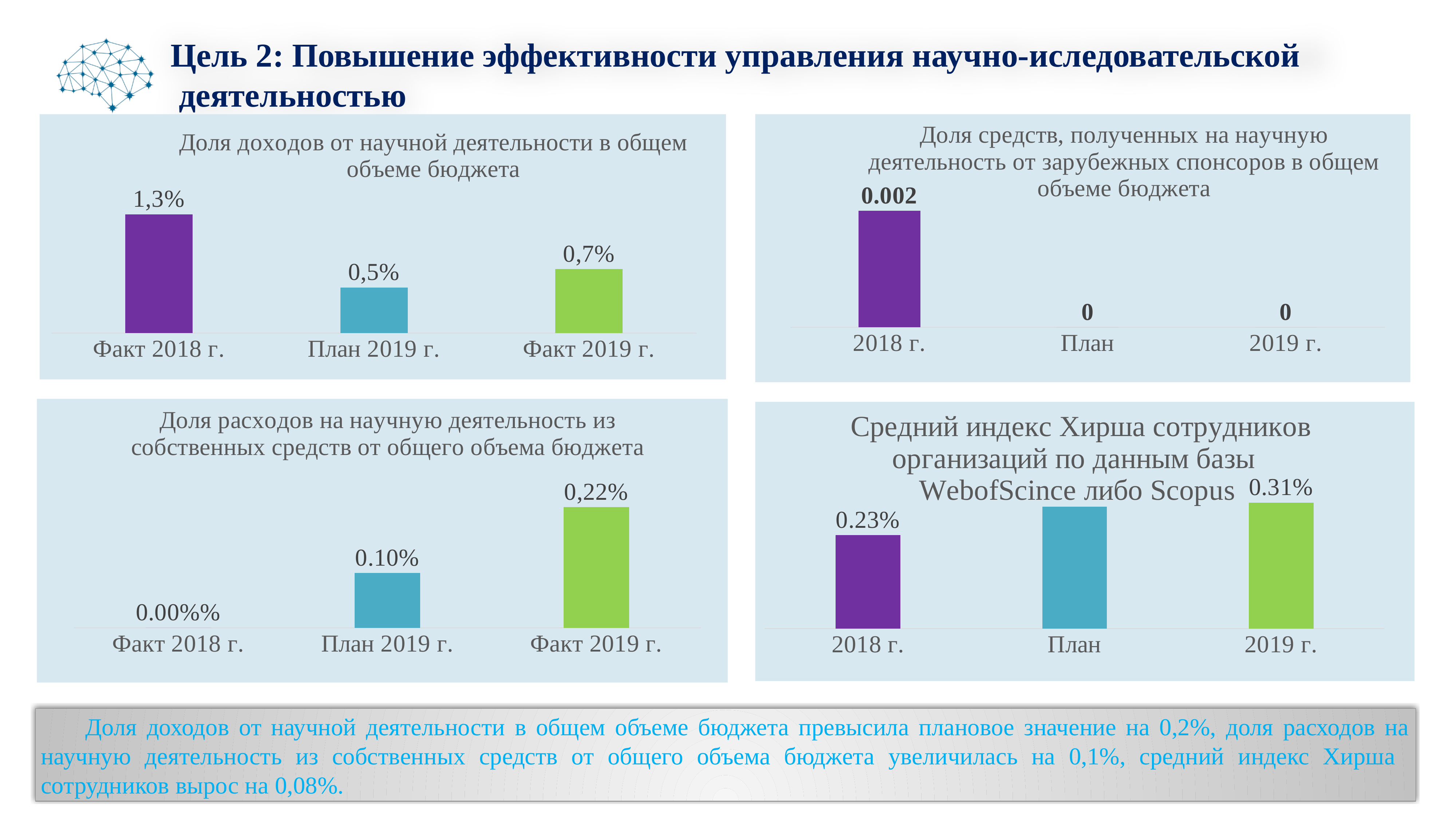
In the chart 'Доля расходов на научную деятельность из собственных средств от общего объема бюджета', what is the value for План 2019 г.? 0.10% In the top-right chart about funds from foreign sponsors, what is the value for План? 0 In the chart 'Доля расходов на научную деятельность из собственных средств от общего объема бюджета', do the values rise or fall from left to right? rise In the chart 'Доля доходов от научной деятельности в общем объеме бюджета', which category has the highest value? Факт 2018 г. In the bottom-right chart about the average Hirsch index, which is larger: 2018 г. or 2019 г.? 2019 г. In the chart 'Доля доходов от научной деятельности в общем объеме бюджета', what is the value for План 2019 г.? 0,5% In the chart 'Доля доходов от научной деятельности в общем объеме бюджета', what is the difference between Факт 2019 г. and План 2019 г.? 0,2% In the chart 'Доля расходов на научную деятельность из собственных средств от общего объема бюджета', what is the value for Факт 2019 г.? 0,22% In the top-right chart about funds from foreign sponsors, what is the value for 2018 г.? 0.002 How many categories are shown in the top-right chart about funds from foreign sponsors? 3 In the bottom-right chart about the average Hirsch index, what is the value for 2019 г.? 0.31% In the chart 'Доля доходов от научной деятельности в общем объеме бюджета', what is the value for Факт 2018 г.? 1,3%